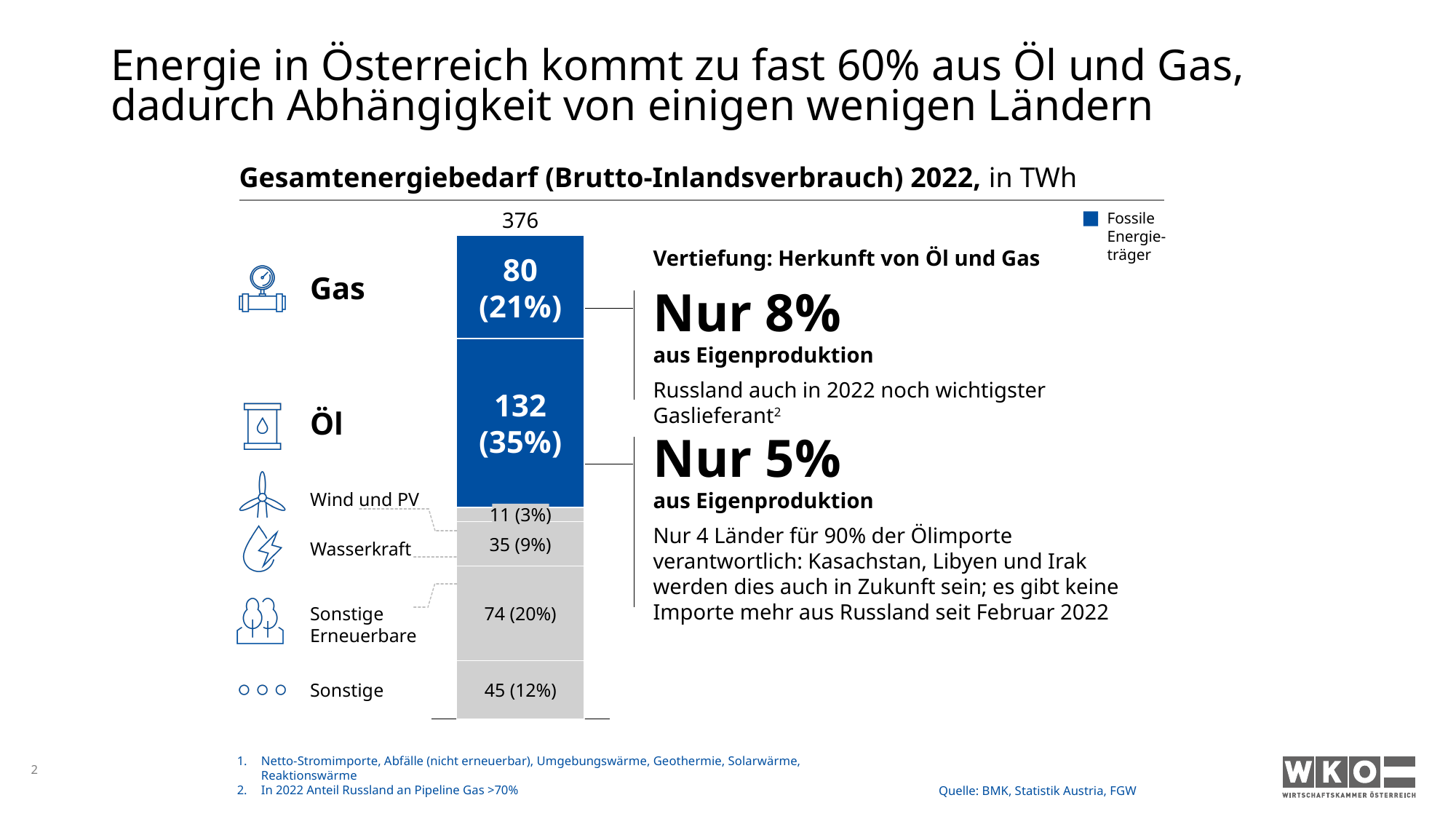
Which segment of the stacked bar has the lowest value? Wind und PV What is the difference between the values for Öl and Gas? 52 What is the value for Sonstige Erneuerbare? 74 What kind of chart is shown on the slide? Stacked bar chart What is the value for Öl in the stacked bar? 132 How many segments does the stacked bar contain? 6 Which is larger, the value for Sonstige Erneuerbare or the value for Sonstige? Sonstige Erneuerbare Which segment of the stacked bar has the highest value? Öl What percentage share is shown for Wasserkraft? 9% What does the blue colour in the chart represent according to the legend? Fossile Energieträger What is the value for Gas in the stacked bar? 80 What is the total of the stacked bar? 376